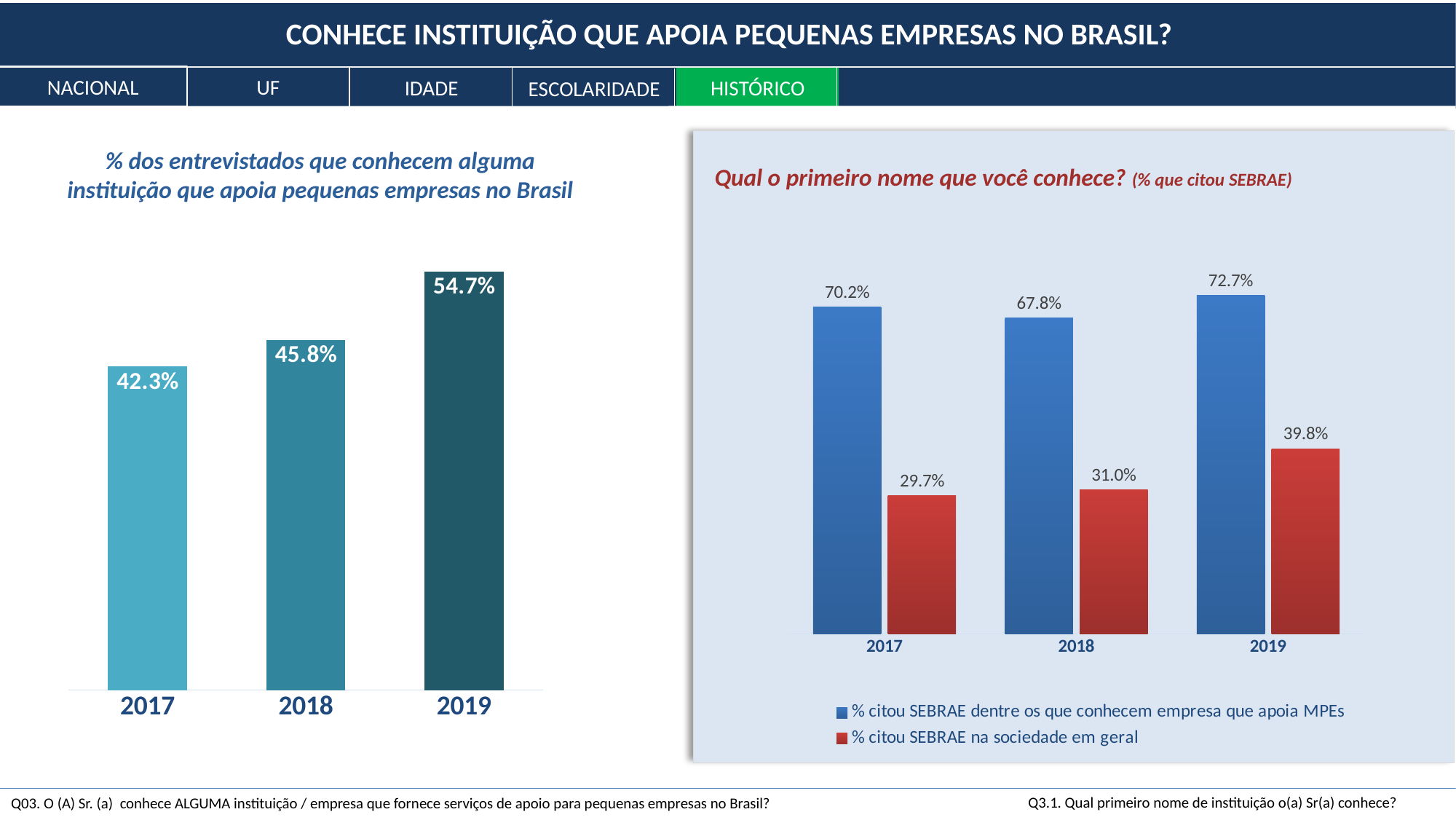
In the right chart, which year has the highest value for '% citou SEBRAE dentre os que conhecem empresa que apoia MPEs'? 2019 In the left chart, which year has the lowest value? 2017 In the left chart, what is the value for 2017? 42.3% What type of chart is the right chart? bar chart In the right chart, what is the difference between the two series in 2017? 40.5 percentage points In the right chart (Qual o primeiro nome que você conhece?), what is the value for '% citou SEBRAE na sociedade em geral' in 2018? 31.0% In the right chart, what is the value for '% citou SEBRAE dentre os que conhecem empresa que apoia MPEs' in 2019? 72.7% In the left chart, what is the difference between the 2019 and 2018 values? 8.9 percentage points In the left chart, do the values rise or fall from 2017 to 2019? rise In the left chart (% dos entrevistados que conhecem alguma instituição que apoia pequenas empresas no Brasil), what is the value for 2019? 54.7% In the left chart, how many years are shown? 3 In the right chart, how many series does the legend list? 2